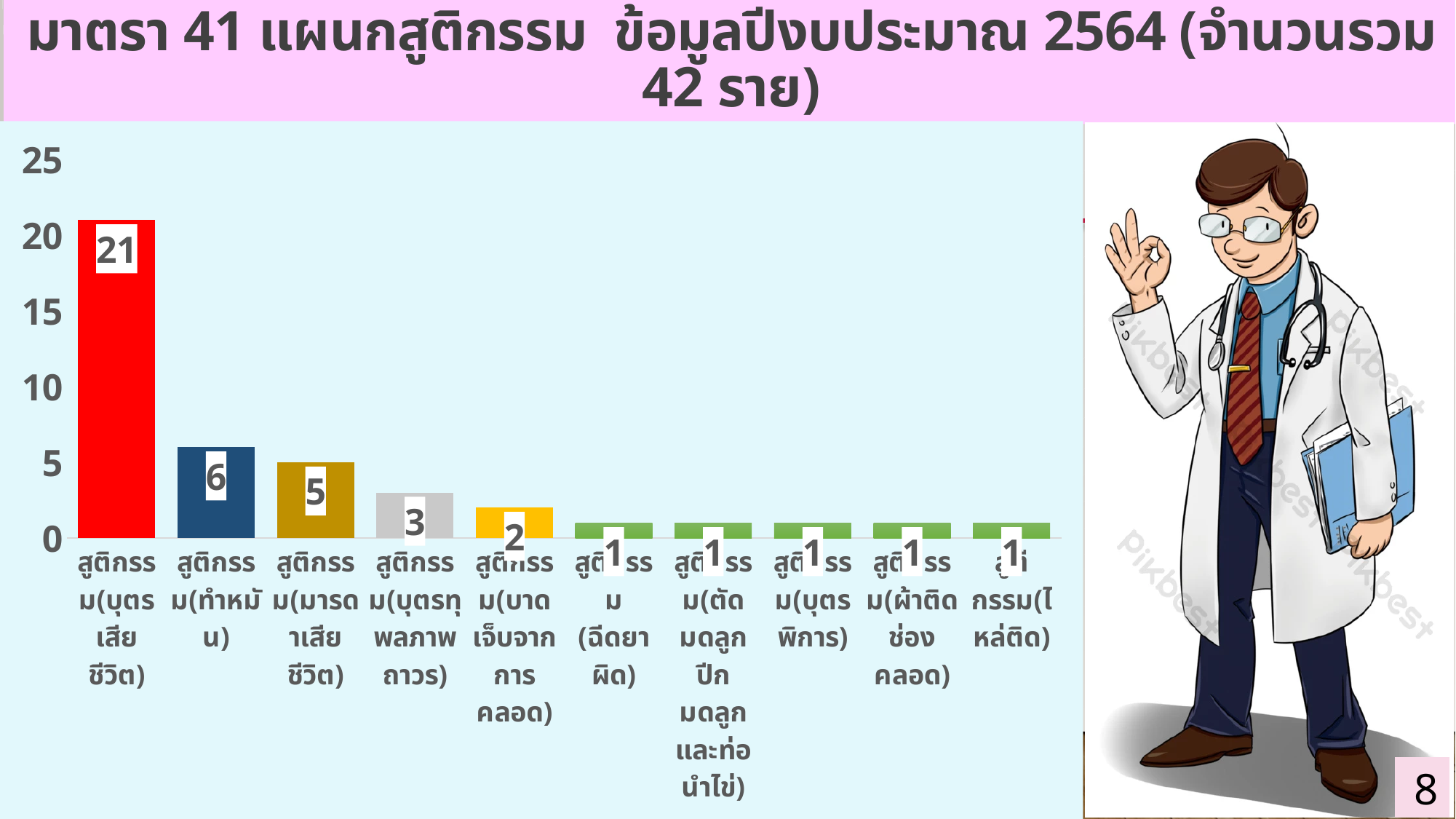
How many categories are shown on the x axis of the chart? 10 Which category has the highest value? สูติกรรม(บุตรเสียชีวิต) Is the value for สูติกรรม(บุตรเสียชีวิต) greater or less than 20? greater What is the value for สูติกรรม(บุตรทุพลภาพถาวร)? 3 Which is larger, the value for สูติกรรม(มารดาเสียชีวิต) or สูติกรรม(บุตรทุพลภาพถาวร)? สูติกรรม(มารดาเสียชีวิต) What is the value for สูติกรรม(บาดเจ็บจากการคลอด)? 2 What is the difference between the values for สูติกรรม(บุตรเสียชีวิต) and สูติกรรม(ทำหมัน)? 15 What is the value for สูติกรรม(มารดาเสียชีวิต)? 5 What type of chart is shown on the slide? bar chart What is the value for สูติกรรม(บุตรเสียชีวิต)? 21 What is the value for สูติกรรม(บุตรพิการ)? 1 What is the value for สูติกรรม(ทำหมัน)? 6